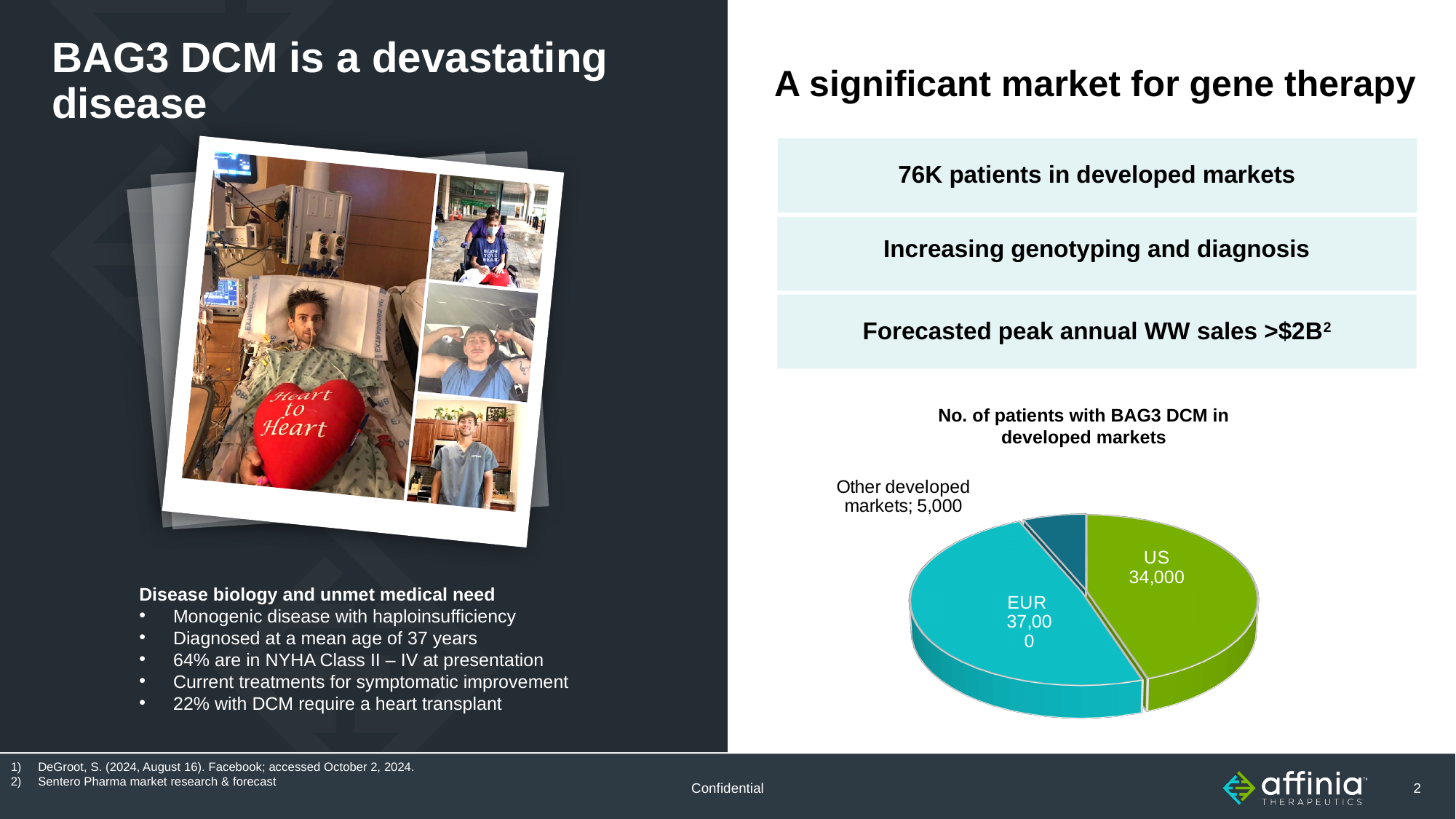
What is the total number of patients across all slices of the pie chart? 76,000 What colour is the US slice of the pie chart? green What is the number of patients in the US according to the pie chart? 34,000 What is the number of patients in EUR according to the pie chart? 37,000 What is the number of patients in Other developed markets according to the pie chart? 5,000 Which region has the largest number of patients in the pie chart? EUR What is the title of the chart? No. of patients with BAG3 DCM in developed markets Which region has the smallest number of patients in the pie chart? Other developed markets What is the difference between the number of patients in EUR and in the US? 3,000 What type of chart is shown on the slide? pie chart How many slices does the pie chart have? 3 Which has more patients, the US or Other developed markets? US